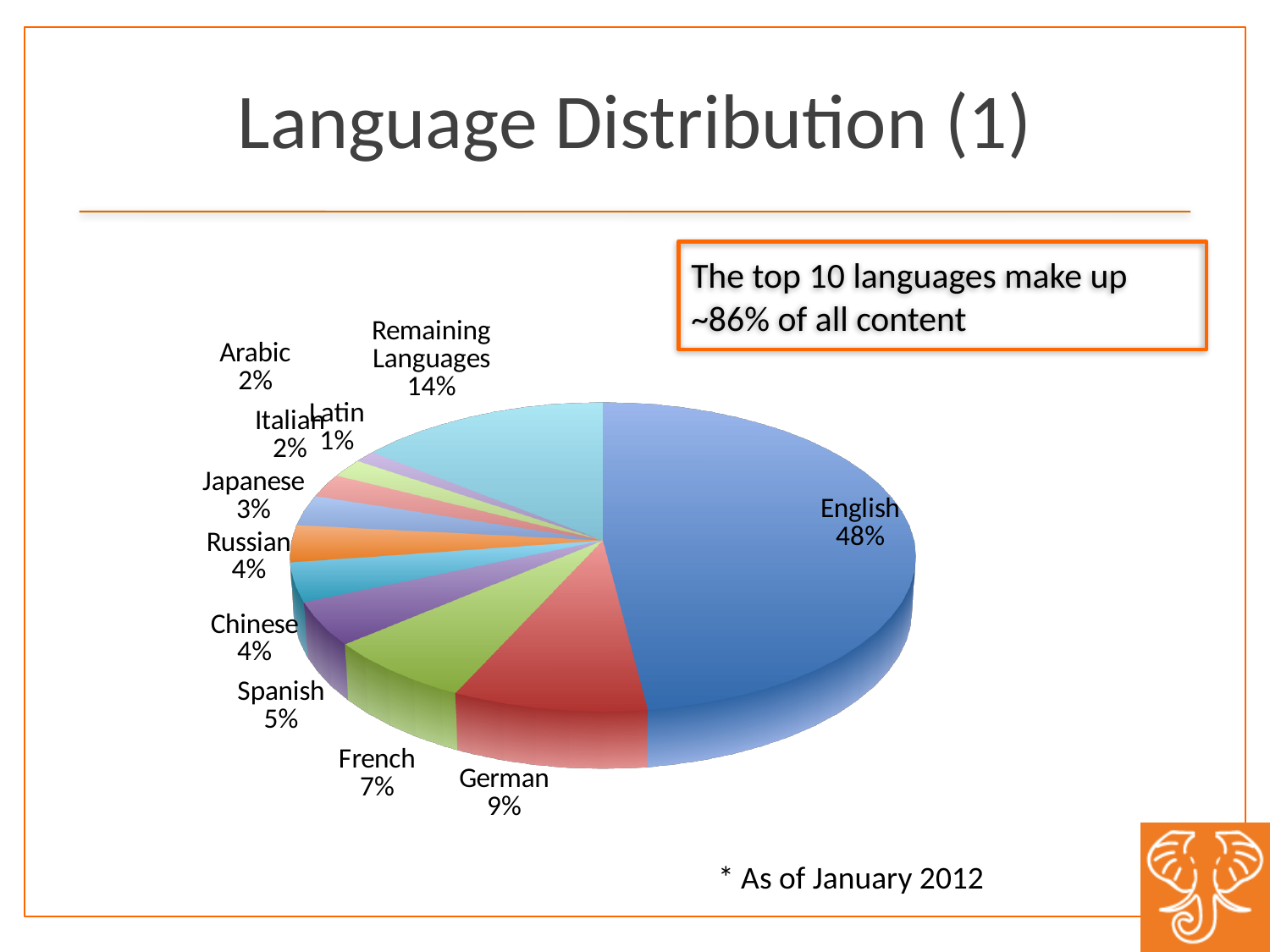
What share is shown for Remaining Languages? 14% Which language has the largest slice of the pie? English What percentage is labelled for German? 9% How many slices are labelled in the pie chart? 11 What kind of chart is shown on the slide? pie chart What share of content is English? 48% Which has a larger share, French or Spanish? French According to the callout box, what share of all content do the top 10 languages make up? ~86% What is the difference in percentage points between English and German? 39 What percentage is shown for Japanese? 3% Which labelled slice has the smallest share? Latin What is the combined share of Chinese and Russian? 8%